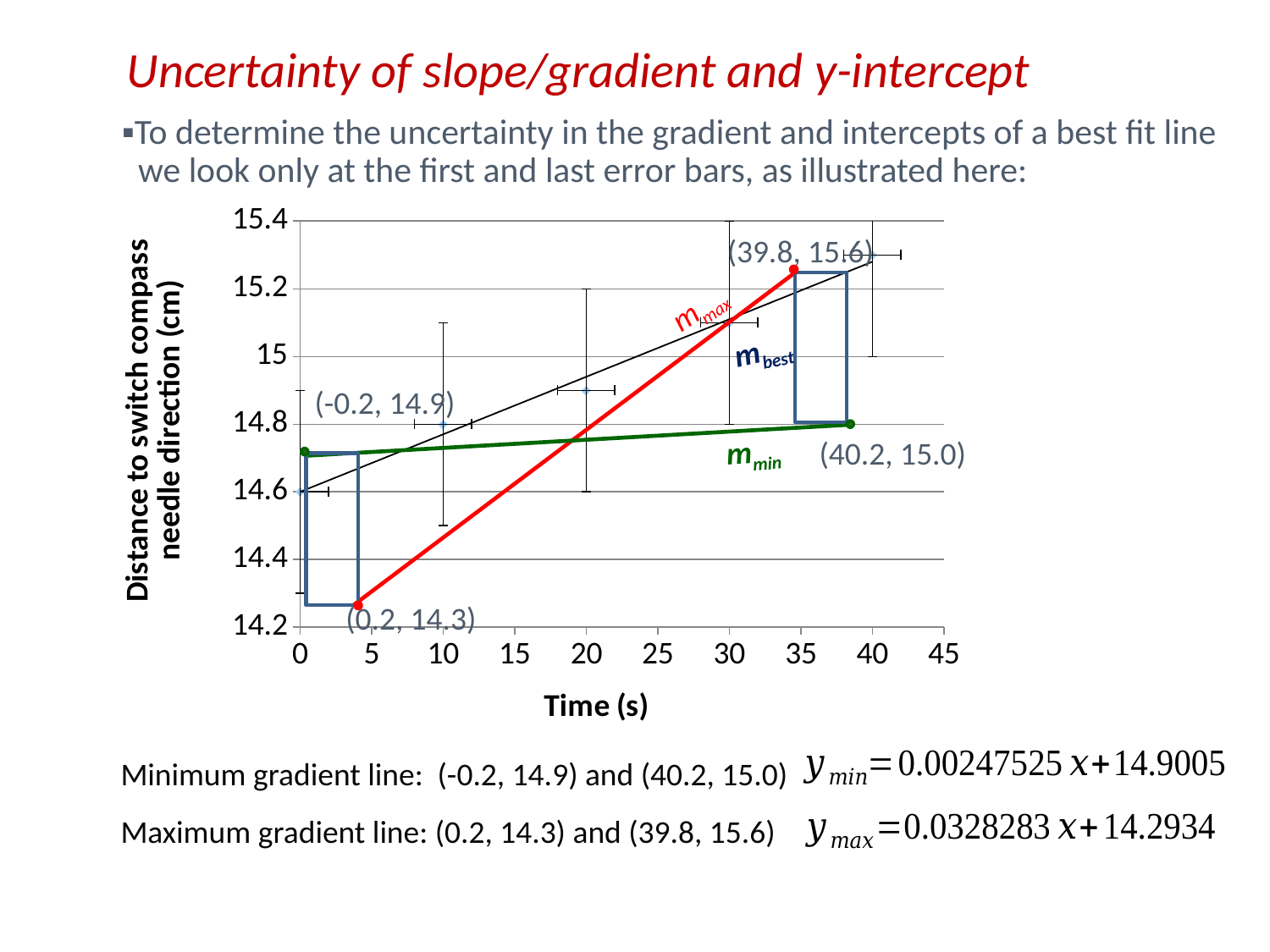
Is the plotted value at time 0 s greater or less than 14.8? less How many data points with error bars are plotted on the chart? 5 What is the label of the y axis of the chart? Distance to switch compass needle direction (cm) What coordinates are labelled at the lower-left end of the maximum gradient (red) line? (0.2, 14.3) Is the plotted value at time 40 s greater or less than 15.2? greater Do the plotted distance values rise or fall as time increases? rise What kind of chart is shown on the slide? scatter chart Which of the three labelled lines on the chart has the steepest slope? m_max Is the plotted value at time 20 s greater or less than 15? less What is the label of the x axis of the chart? Time (s) What coordinates are labelled at the right end of the minimum gradient (green) line? (40.2, 15.0)